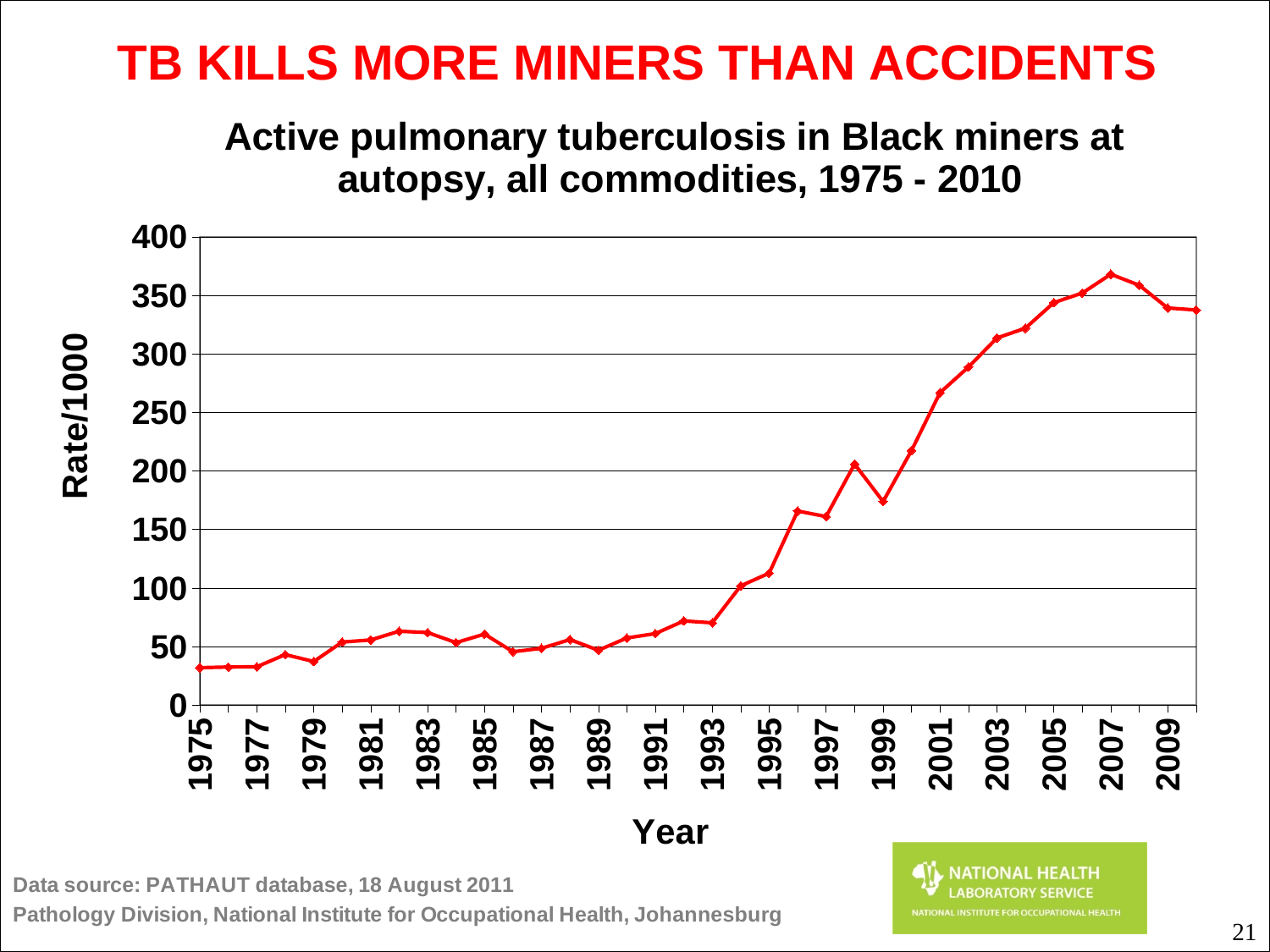
What kind of chart is shown on the slide? line chart Is the value for 2010 greater or less than 350? less What is the label on the vertical axis? Rate/1000 In which year does the TB rate reach its highest value? 2007 Is the value for 1999 greater or less than 200? less What is the label on the horizontal axis? Year Which year has the larger value, 1998 or 1999? 1998 Does the TB rate rise or fall between 1993 and 2007? rise Which year has the larger value, 2007 or 2010? 2007 Is the value for 2001 greater or less than 250? greater